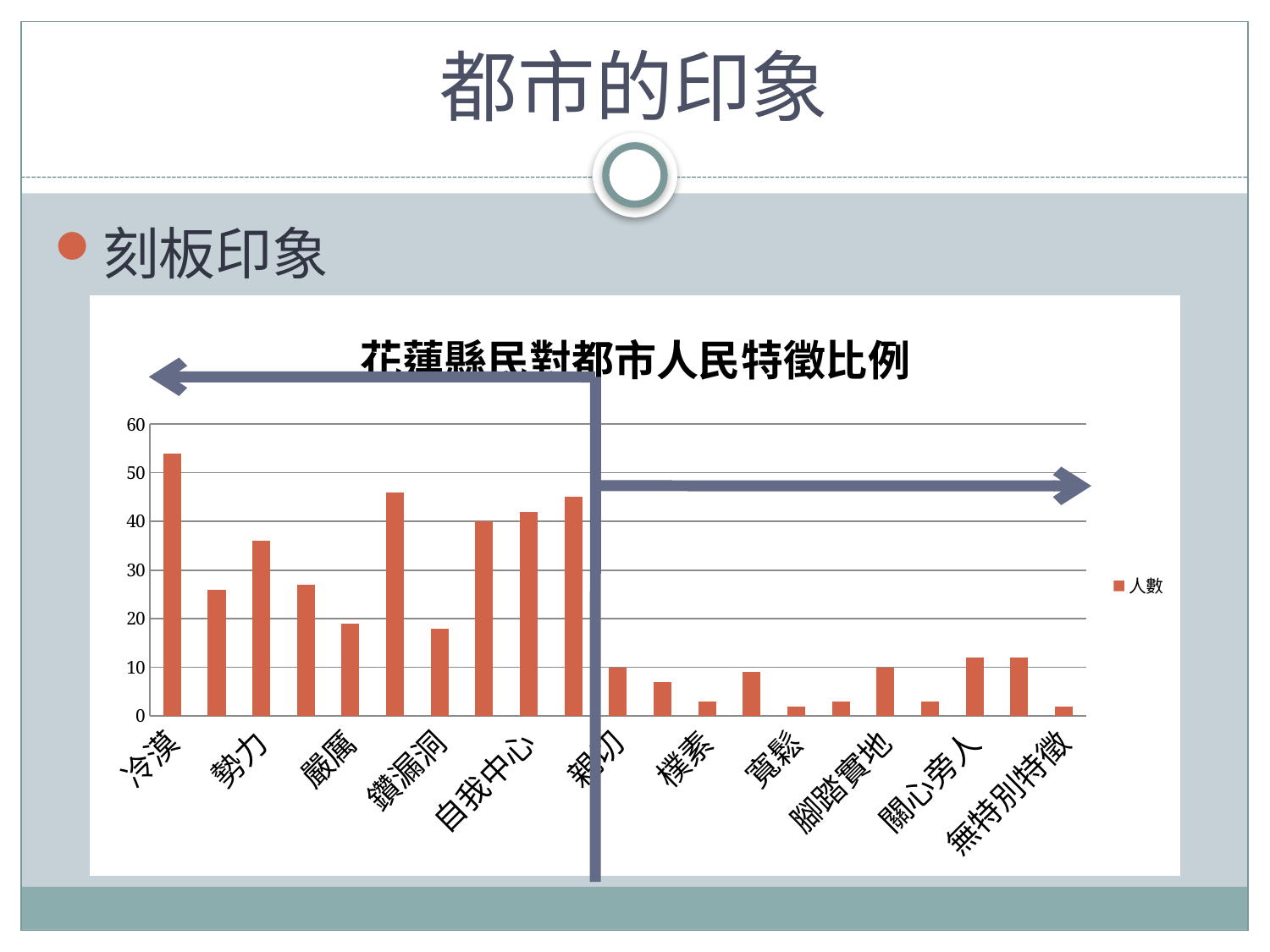
Which has a larger value, 冷漠 or 親切? 冷漠 Which labeled category has the highest value? 冷漠 Is the value for 親切 greater or less than 20? less Is the value for 樸素 greater or less than 10? less Which has a larger value, 勢力 or 無特別特徵? 勢力 Is the value for 自我中心 greater or less than 30? greater What is the name of the series shown in the legend? 人數 How many series does the legend list? 1 What is the title of the chart? 花蓮縣民對都市人民特徵比例 What kind of chart is shown on the slide? bar chart